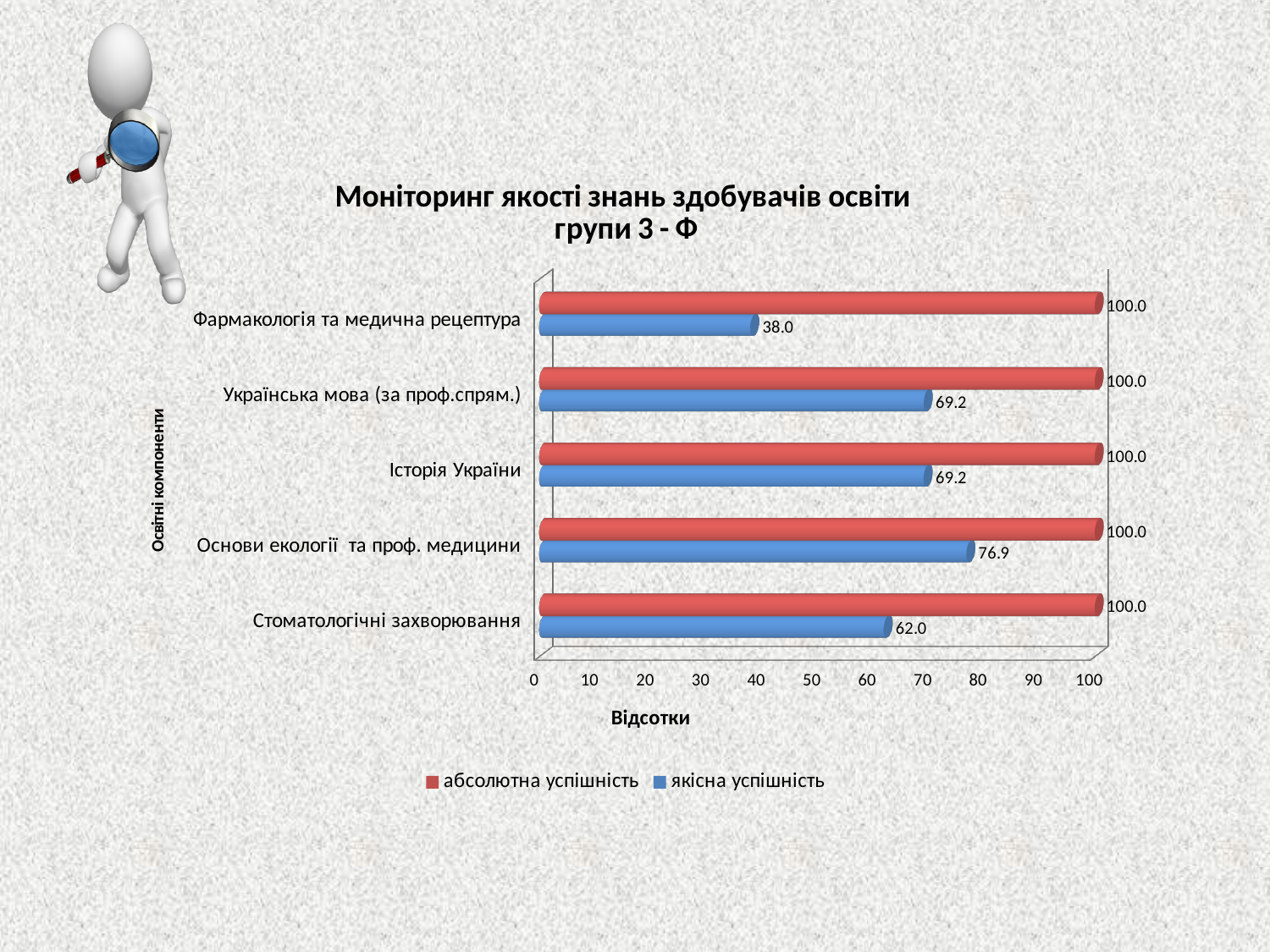
What is the якісна успішність value for Стоматологічні захворювання? 62.0 What is the абсолютна успішність value for Стоматологічні захворювання? 100.0 What is the якісна успішність value for Основи екології та проф. медицини? 76.9 What is the label of the horizontal axis? Відсотки How many categories are shown on the chart? 5 Which is larger: the якісна успішність value for Стоматологічні захворювання or for Історія України? Історія України What kind of chart is shown on the slide? Bar chart Which category has the lowest якісна успішність value? Фармакологія та медична рецептура What is the якісна успішність value for Фармакологія та медична рецептура? 38.0 What is the difference between the абсолютна успішність and якісна успішність values for Фармакологія та медична рецептура? 62.0 How many series does the legend list? 2 Which category has the highest якісна успішність value? Основи екології та проф. медицини